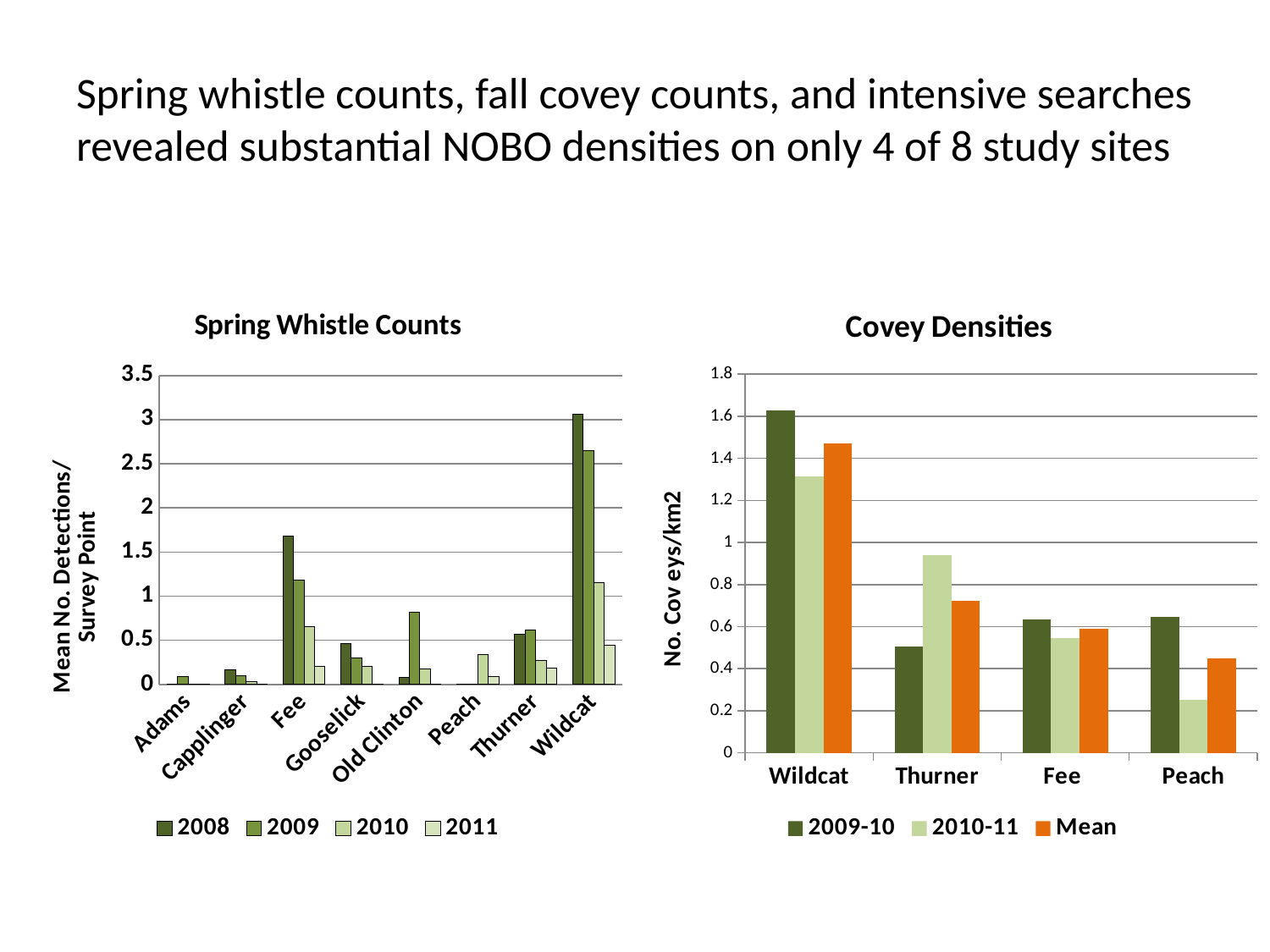
In the Spring Whistle Counts chart, is the 2008 value for Fee greater or less than 1.5? greater In the Spring Whistle Counts chart, is the 2009 value for Wildcat greater or less than 2.5? greater In the Covey Densities chart, which is larger for Thurner: the 2009-10 value or the 2010-11 value? 2010-11 In the Covey Densities chart, is the Mean value for Wildcat greater or less than 1.4? greater How many sites are shown on the x axis of the Spring Whistle Counts chart? 8 What kind of chart is the Covey Densities chart? Bar chart In the Covey Densities chart, which site has the lowest 2010-11 value? Peach What is the y-axis label of the Covey Densities chart? No. Coveys/km2 In the Spring Whistle Counts chart, which site has the highest 2008 value? Wildcat In the Covey Densities chart, which site has the highest 2009-10 value? Wildcat How many series does the legend of the Spring Whistle Counts chart list? 4